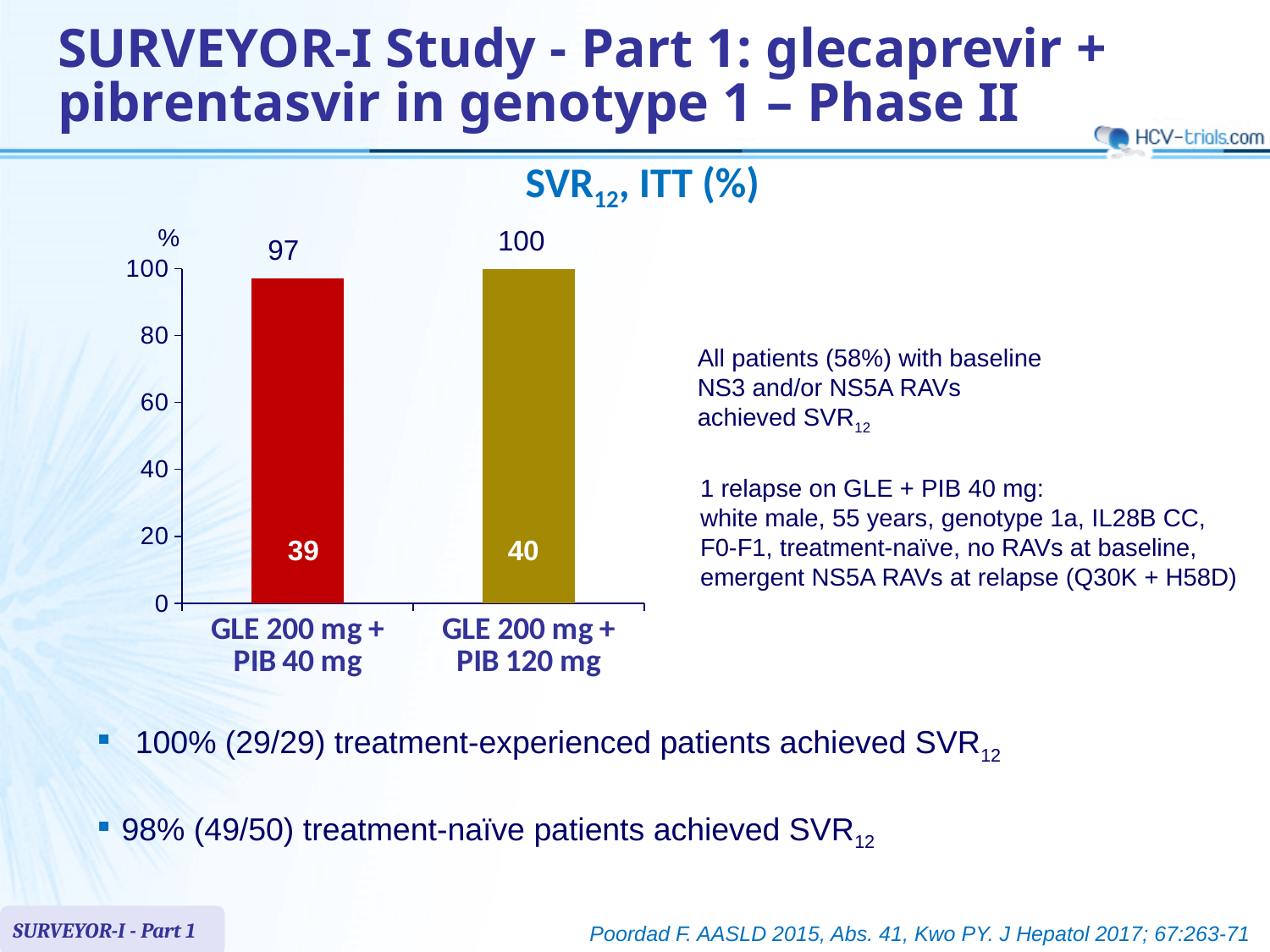
What is the title of the chart? SVR12, ITT (%) How many treatment arms are shown in the chart? 2 Which treatment arm has the lowest SVR12 value? GLE 200 mg + PIB 40 mg What is the difference in SVR12 between GLE 200 mg + PIB 120 mg and GLE 200 mg + PIB 40 mg? 3 What number is printed inside the bar for GLE 200 mg + PIB 40 mg? 39 Is the value for GLE 200 mg + PIB 40 mg greater or less than 80? greater What kind of chart is shown on the slide? Bar chart Which treatment arm has the highest SVR12 value? GLE 200 mg + PIB 120 mg What is the SVR12 value for GLE 200 mg + PIB 40 mg? 97 Which is larger, the SVR12 for GLE 200 mg + PIB 40 mg or for GLE 200 mg + PIB 120 mg? GLE 200 mg + PIB 120 mg What is the SVR12 value for GLE 200 mg + PIB 120 mg? 100 What number is printed inside the bar for GLE 200 mg + PIB 120 mg? 40